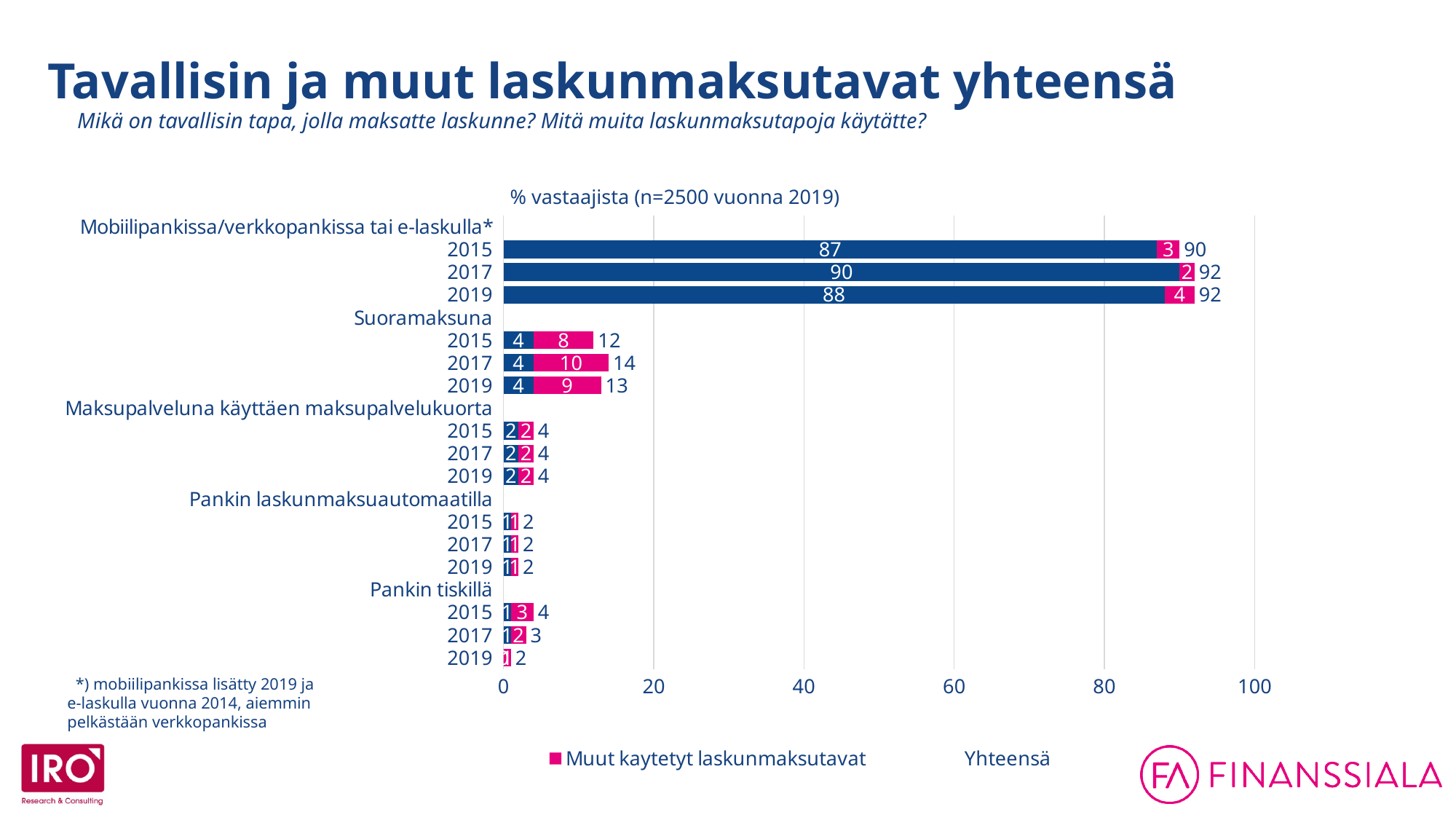
Which year has the lowest total for Pankin tiskillä? 2019 What is the blue (usual payment method) value for Mobiilipankissa/verkkopankissa tai e-laskulla* in 2015? 87 What is the total value for Suoramaksuna in 2019? 13 What is the total for Pankin laskunmaksuautomaatilla in 2017? 2 Which is larger: the total for Suoramaksuna in 2015 or the total for Maksupalveluna käyttäen maksupalvelukuorta in 2015? Suoramaksuna in 2015 What is the difference between the total for Mobiilipankissa/verkkopankissa tai e-laskulla* in 2017 and in 2015? 2 What is the axis title shown above the chart? % vastaajista (n=2500 vuonna 2019) Which year has the highest total for Suoramaksuna? 2017 Is the total for Mobiilipankissa/verkkopankissa tai e-laskulla* in 2019 greater or less than 80? greater What type of chart is shown on the slide? Stacked bar chart What is the total value for Mobiilipankissa/verkkopankissa tai e-laskulla* in 2019? 92 What is the pink 'Muut kaytetyt laskunmaksutavat' value for Suoramaksuna in 2017? 10